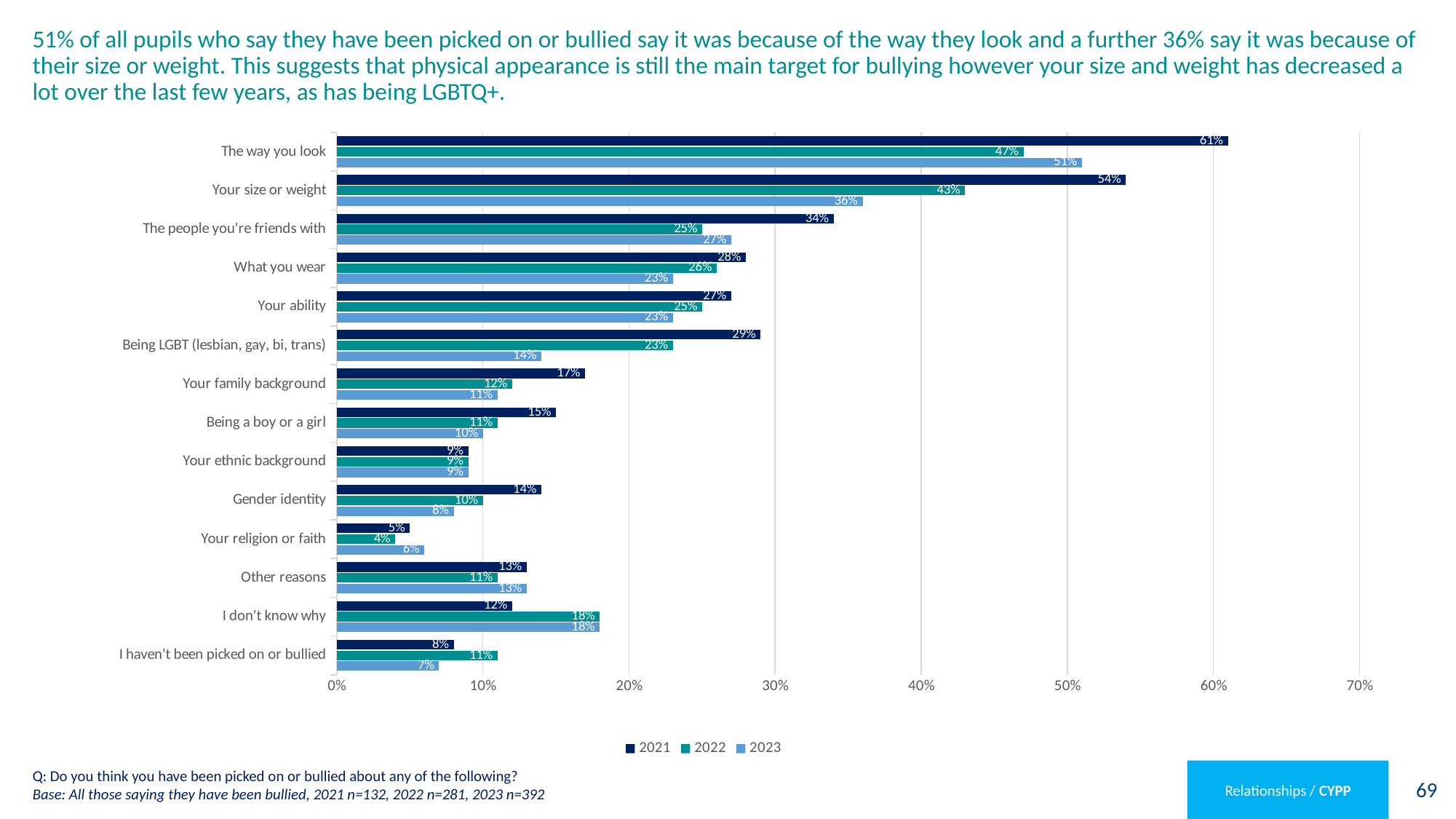
How many series does the legend list? 3 Which years are listed in the chart legend? 2021, 2022, 2023 What is the 2021 value for "Being LGBT (lesbian, gay, bi, trans)"? 29% What is the 2023 value for "Your religion or faith"? 6% What is the difference between the 2021 and 2023 values for "Being LGBT (lesbian, gay, bi, trans)"? 15% What kind of chart is shown on the slide? Bar chart Which category has the highest 2021 value? The way you look Which is larger for "The way you look": the 2022 value or the 2023 value? 2023 What is the 2022 value for "I don't know why"? 18% What is the 2023 value for "Your size or weight"? 36% How many categories are shown on the chart? 14 Which category has the lowest 2022 value? Your religion or faith